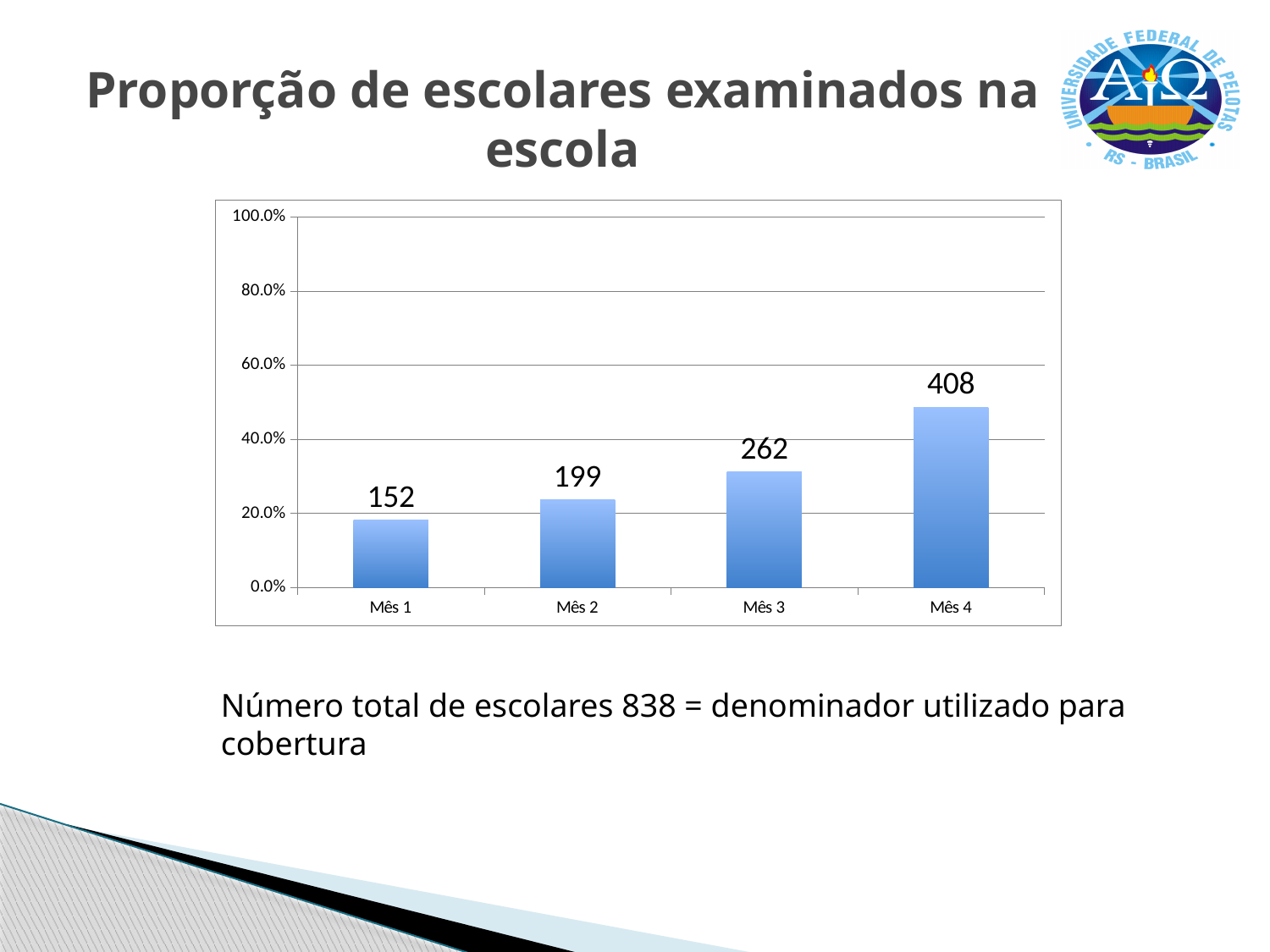
Which month has the highest bar? Mês 4 Is the bar for Mês 4 greater or less than 40.0% on the y axis? greater Do the bar values rise or fall from Mês 1 to Mês 4? rise What is the difference between the data labels for Mês 4 and Mês 3? 146 How many months are shown on the x axis? 4 Is the bar for Mês 1 greater or less than 20.0% on the y axis? less Which has a larger value, Mês 2 or Mês 3? Mês 3 What data label is shown on the bar for Mês 4? 408 What data label is shown on the bar for Mês 3? 262 What data label is shown on the bar for Mês 1? 152 What data label is shown on the bar for Mês 2? 199 Which month has the lowest bar? Mês 1